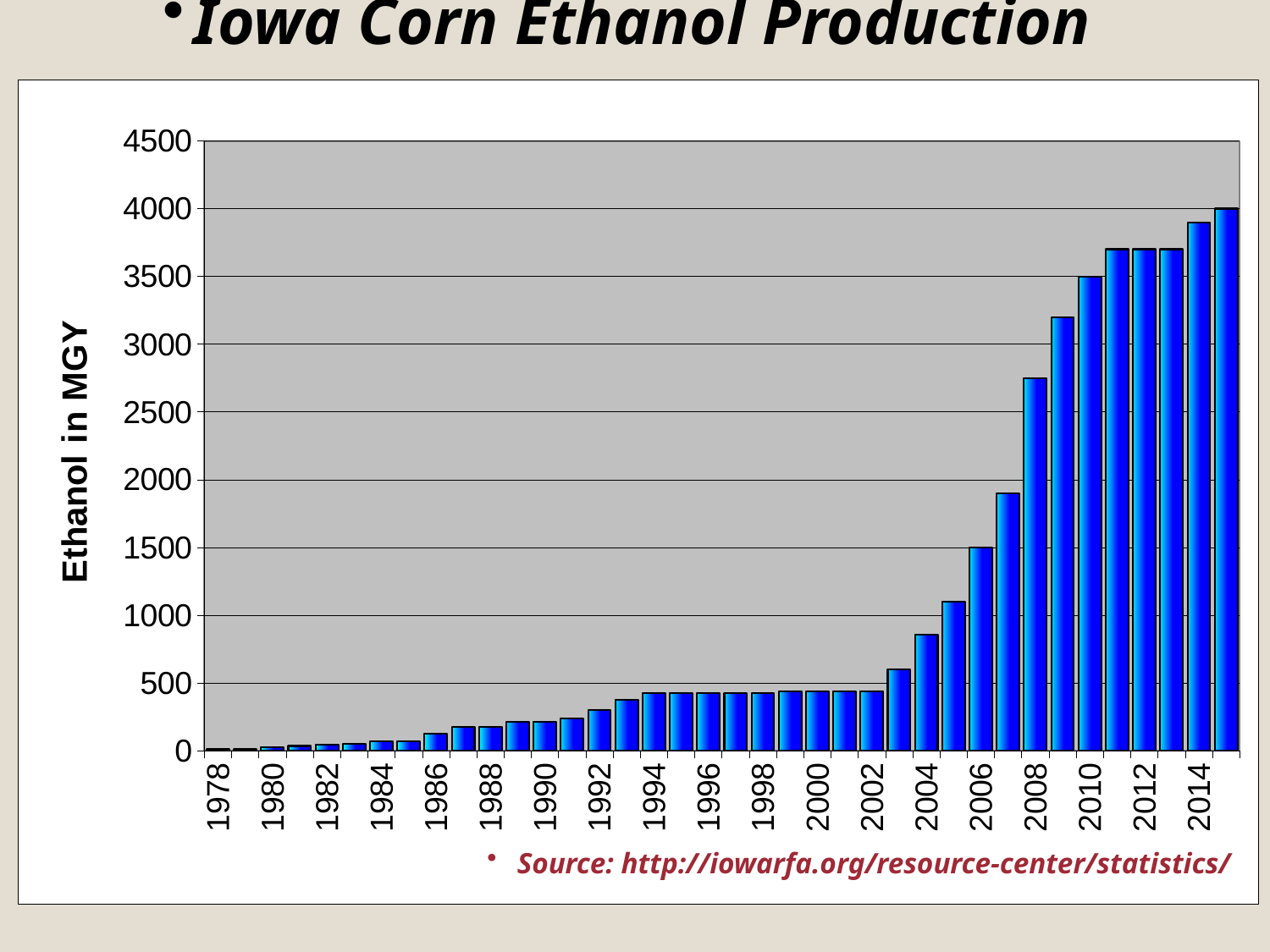
Is the value for 2000 greater or less than 500? less Is the value for 2010 greater or less than 3000? greater What kind of chart is shown on the slide? bar chart Is the value for 2014 greater or less than 3500? greater Which labeled year has the lowest ethanol production? 1978 What is the label on the vertical axis? Ethanol in MGY What is the title of the chart? Iowa Corn Ethanol Production Do the values generally rise or fall from 1978 to the right end of the x axis? rise Which year has the larger value, 1986 or 1994? 1994 Which year has the larger value, 2004 or 2008? 2008